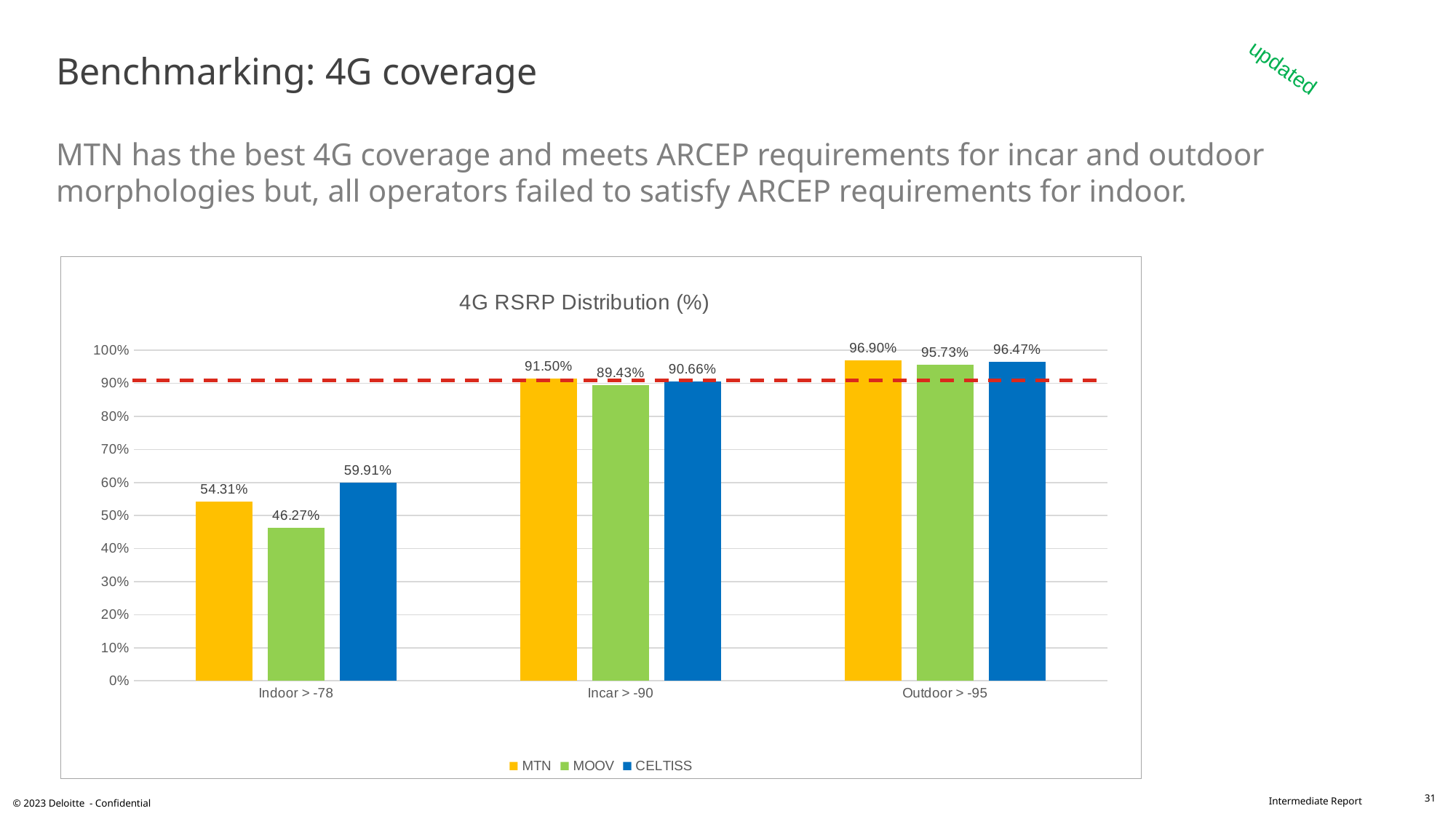
Is the value for MOOV in the Indoor > -78 category greater or less than 50%? less How many series does the legend list? 3 Which is larger: the CELTISS value for Incar > -90 or the MTN value for Incar > -90? MTN What is the value for CELTISS in the Outdoor > -95 category? 96.47% What is the value for MOOV in the Incar > -90 category? 89.43% What kind of chart is shown on the slide? bar chart How many categories are shown on the x axis? 3 What is the value for MTN in the Indoor > -78 category? 54.31% Which operator has the highest value in the Indoor > -78 category? CELTISS Which operator has the lowest value in the Incar > -90 category? MOOV What is the title of the chart? 4G RSRP Distribution (%) What is the difference between the MTN and MOOV values in the Indoor > -78 category? 8.04%